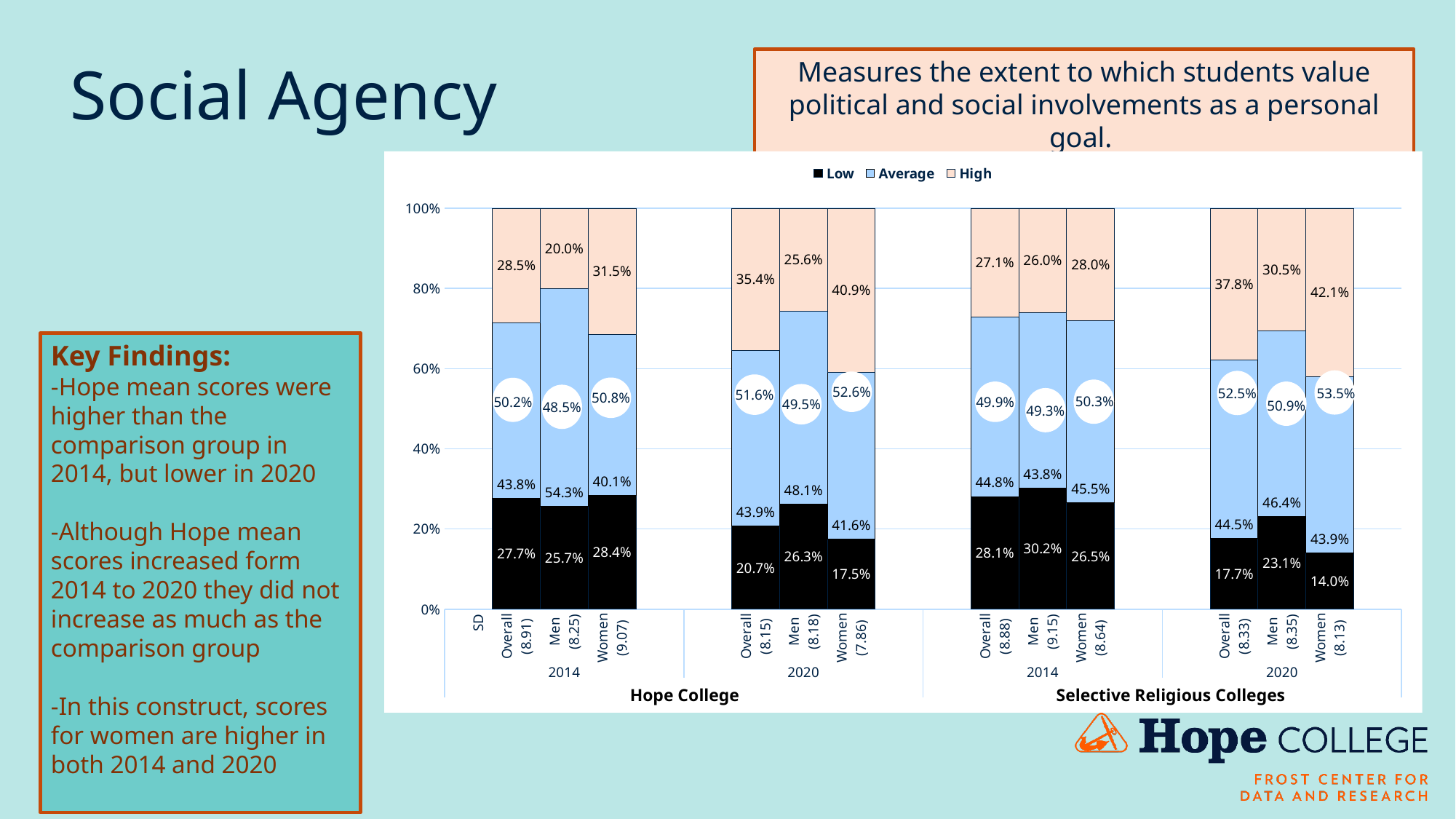
What is the Average percentage for Selective Religious Colleges Overall in 2014? 44.8% How many stacked bars are plotted in the chart? 12 Which bar has the lowest Low percentage? Selective Religious Colleges Women 2020 (14.0%) Which is larger: the Low percentage for Hope College men in 2014 or for Selective Religious Colleges men in 2014? Selective Religious Colleges men in 2014 (30.2%) What are the three series named in the legend? Low, Average, High What percentage of Hope College women in 2014 scored High on Social Agency? 31.5% What is the difference between the High percentage for Hope College women in 2020 and Hope College women in 2014? 9.4 percentage points What is the standard deviation shown for Hope College women in 2020? 7.86 Which bar has the highest High percentage? Selective Religious Colleges Women 2020 (42.1%) What type of chart is shown on the slide? Stacked bar chart What is the Low percentage for Hope College men in 2020? 26.3% How many series does the legend list? 3